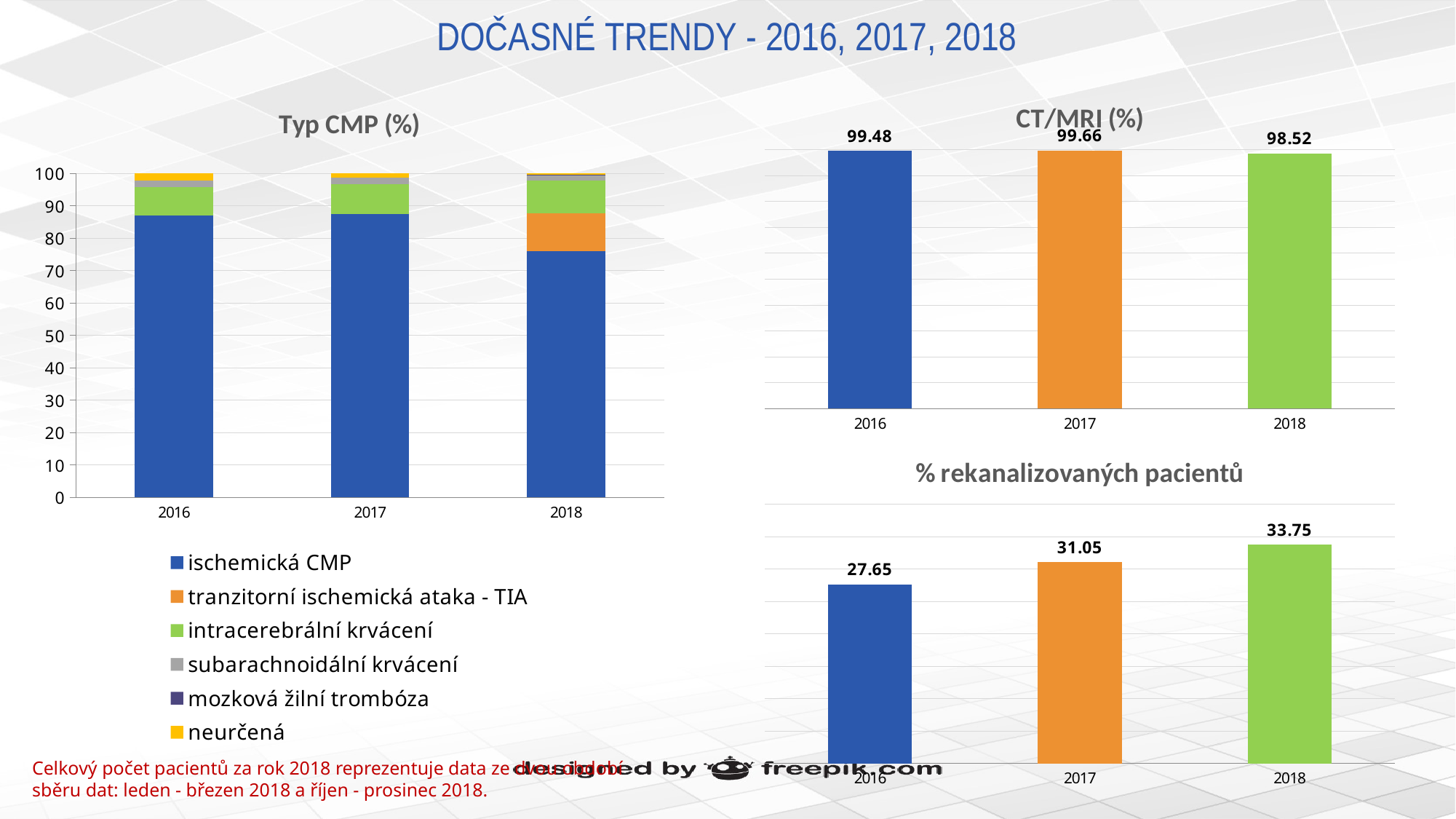
How many series does the legend of the Typ CMP (%) chart list? 6 In the CT/MRI (%) chart, which year has the lowest value? 2018 In the Typ CMP (%) chart, is the ischemická CMP value for 2018 greater or less than 80? less In the CT/MRI (%) chart, what is the value for 2018? 98.52 In the % rekanalizovaných pacientů chart, what is the value for 2016? 27.65 In the % rekanalizovaných pacientů chart, which is larger, the value for 2017 or the value for 2016? 2017 What kind of chart is the Typ CMP (%) chart? stacked bar chart In the CT/MRI (%) chart, what is the value for 2017? 99.66 In the % rekanalizovaných pacientů chart, which year has the highest value? 2018 In the % rekanalizovaných pacientů chart, do the values rise or fall from 2016 to 2018? rise In the % rekanalizovaných pacientů chart, what is the difference between the 2018 and 2016 values? 6.1 How many years are shown on the x axis of the CT/MRI (%) chart? 3